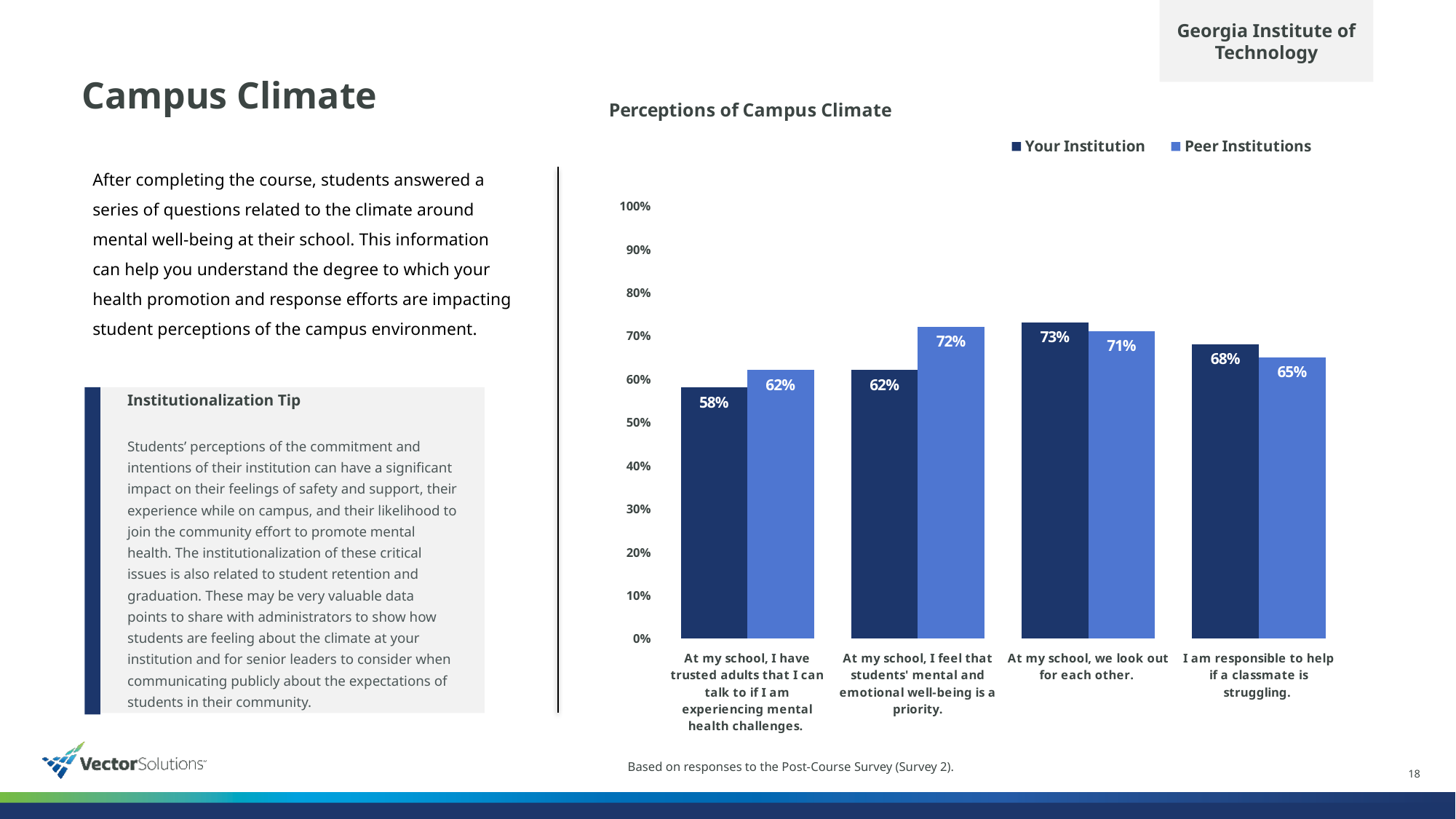
What kind of chart is shown on the slide? Bar chart Which category has the lowest Peer Institutions value? At my school, I have trusted adults that I can talk to if I am experiencing mental health challenges. For "At my school, we look out for each other.", which is larger: Your Institution or Peer Institutions? Your Institution What is the Peer Institutions value for "At my school, I feel that students' mental and emotional well-being is a priority."? 72% What is the Your Institution value for "I am responsible to help if a classmate is struggling."? 68% How many categories are shown on the x axis of the chart? 4 What is the title of the chart? Perceptions of Campus Climate How many series does the chart legend list? 2 Is the Peer Institutions value for "I am responsible to help if a classmate is struggling." greater or less than 60%? greater What is the Your Institution value for "At my school, I have trusted adults that I can talk to if I am experiencing mental health challenges."? 58% Which category has the highest Your Institution value? At my school, we look out for each other. What is the difference between the Peer Institutions and Your Institution values for "At my school, I feel that students' mental and emotional well-being is a priority."? 10%